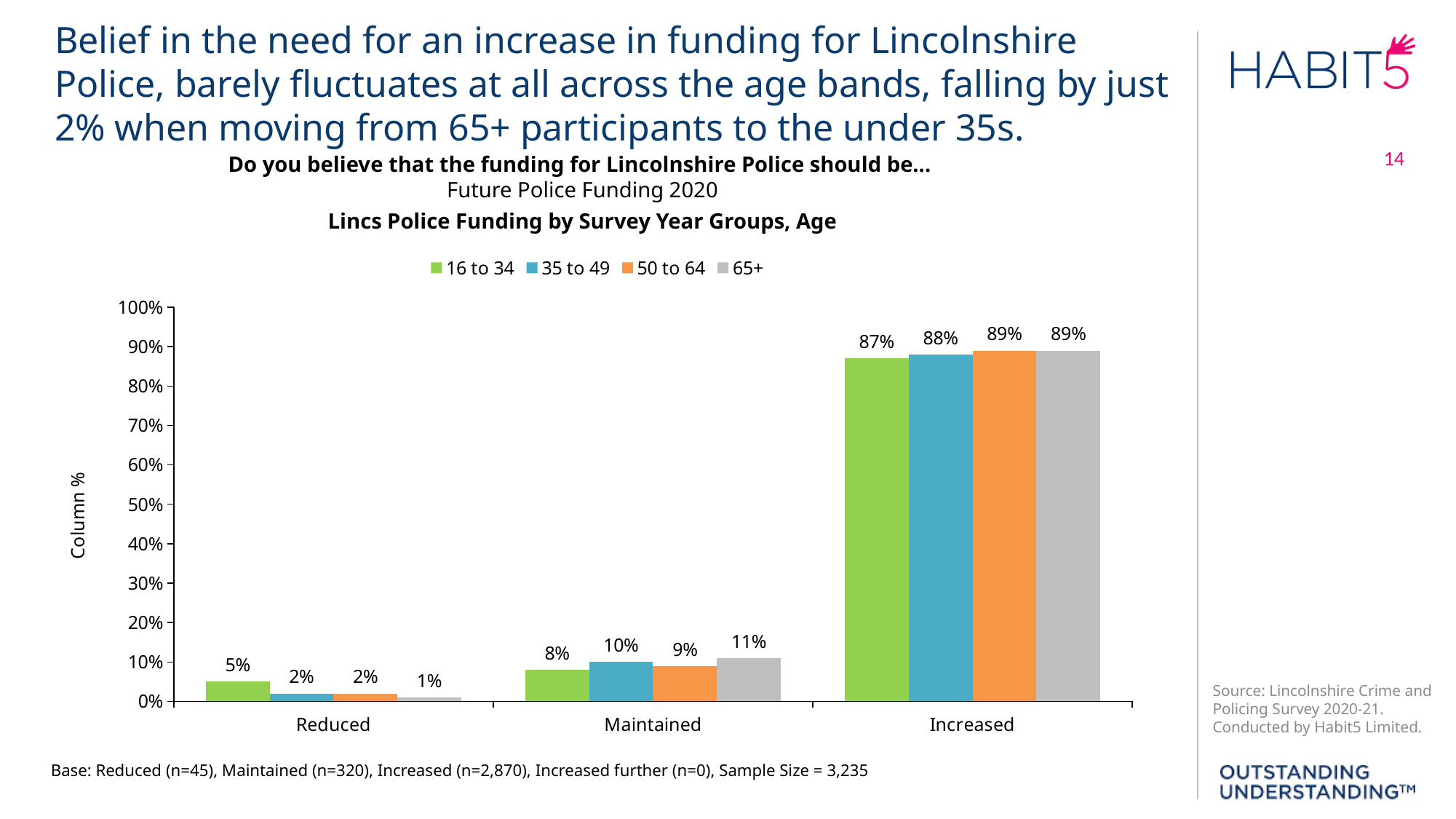
In the Maintained category, is the value for 35 to 49 larger or smaller than the value for 50 to 64? larger What percentage of the 16 to 34 age group believe funding should be Increased? 87% Which age group has the highest value in the Reduced category? 16 to 34 Which age group has the lowest value in the Maintained category? 16 to 34 How many categories are shown on the x axis? 3 What kind of chart is shown on the slide? Bar chart What is the value for the 65+ group in the Maintained category? 11% What is the value for the 35 to 49 group in the Reduced category? 2% Is the value for the 50 to 64 group in the Increased category greater or less than 80%? greater What is the difference between the 65+ and 16 to 34 values in the Increased category? 2% How many series does the legend list? 4 What is the label of the y axis? Column %